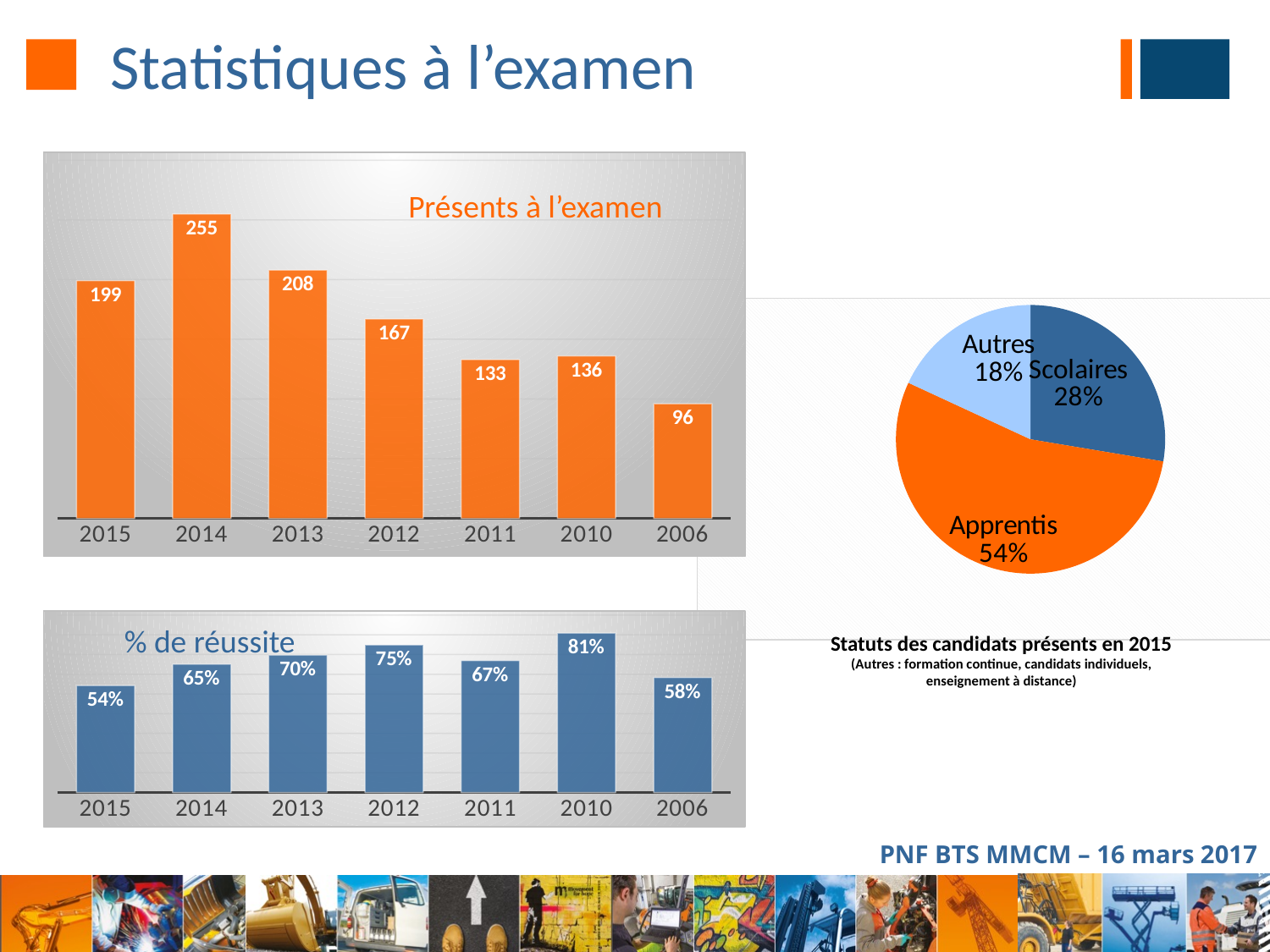
In the '% de réussite' chart, what is the difference between the values for 2012 and 2011? 8% In the 'Présents à l'examen' chart, what is the difference between the values for 2014 and 2015? 56 In the pie chart 'Statuts des candidats présents en 2015', which category has the smallest share? Autres In the 'Présents à l'examen' chart, which year has the lowest value? 2006 What kind of chart is the '% de réussite' chart? Bar chart In the pie chart 'Statuts des candidats présents en 2015', what share do Apprentis represent? 54% In the '% de réussite' chart, which year has the lowest value? 2015 In the 'Présents à l'examen' chart, what is the value for 2014? 255 How many years are shown in the 'Présents à l'examen' chart? 7 In the '% de réussite' chart, what is the value for 2010? 81% In the 'Présents à l'examen' chart, which is larger, the value for 2011 or 2010? 2010 In the 'Présents à l'examen' chart, which year has the highest value? 2014